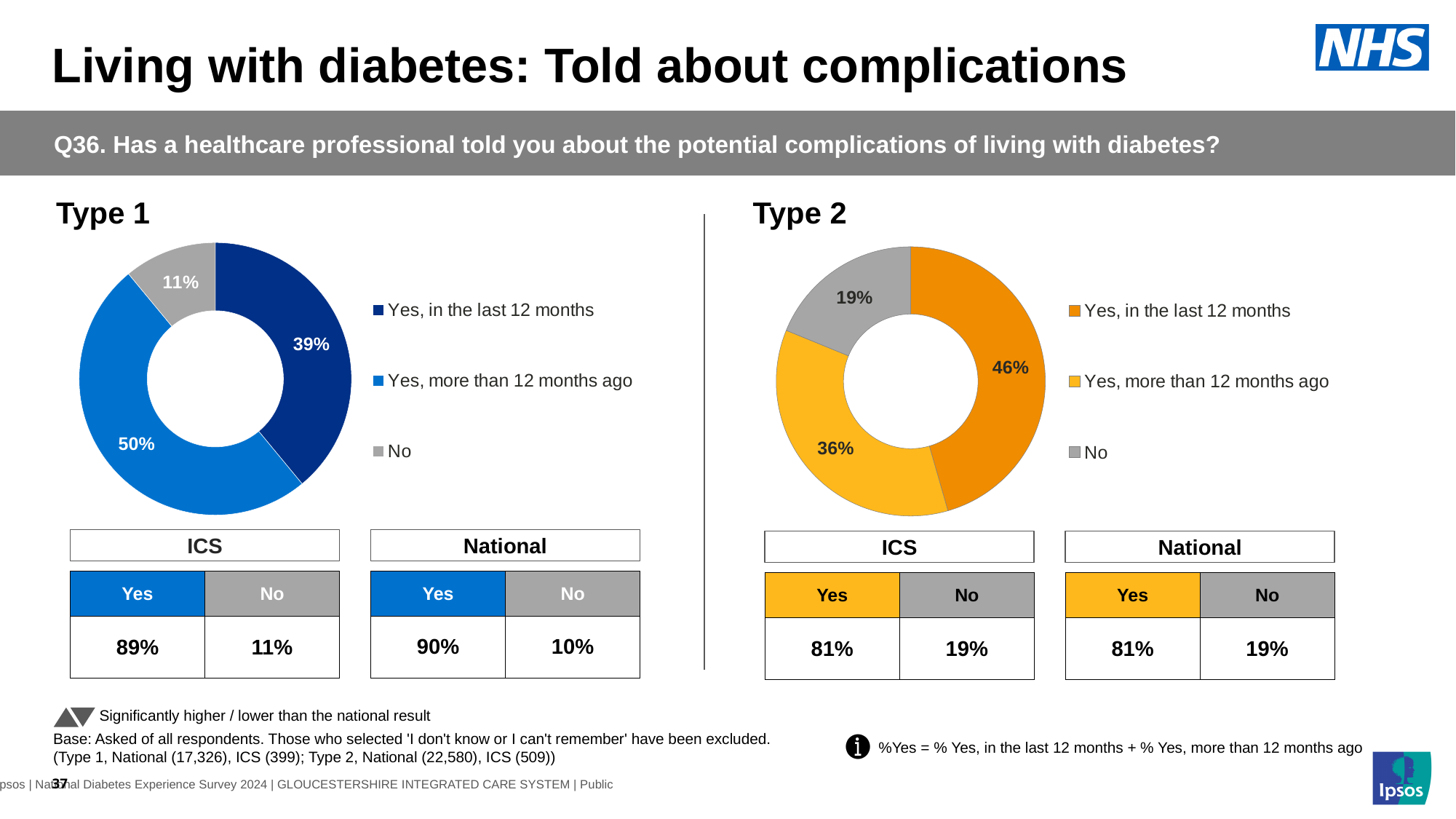
In the Type 2 chart, what percentage of respondents said 'No'? 19% How many categories does the Type 2 chart legend list? 3 In the Type 2 chart, which response has the smallest share? No In the Type 2 chart, what percentage of respondents said 'Yes, in the last 12 months'? 46% In the Type 1 chart, what percentage of respondents said 'Yes, more than 12 months ago'? 50% In the Type 1 chart, what is the combined share of the two 'Yes' responses? 89% In the Type 1 chart, what percentage of respondents said 'Yes, in the last 12 months'? 39% In the Type 2 chart, which is larger: 'Yes, in the last 12 months' or 'Yes, more than 12 months ago'? Yes, in the last 12 months In the Type 2 chart, what colour represents 'Yes, more than 12 months ago'? Yellow What type of chart is used for the Type 1 data? Doughnut chart In the Type 1 chart, what is the difference between the 'Yes, more than 12 months ago' share and the 'No' share? 39% In the Type 1 chart, which response has the largest share? Yes, more than 12 months ago